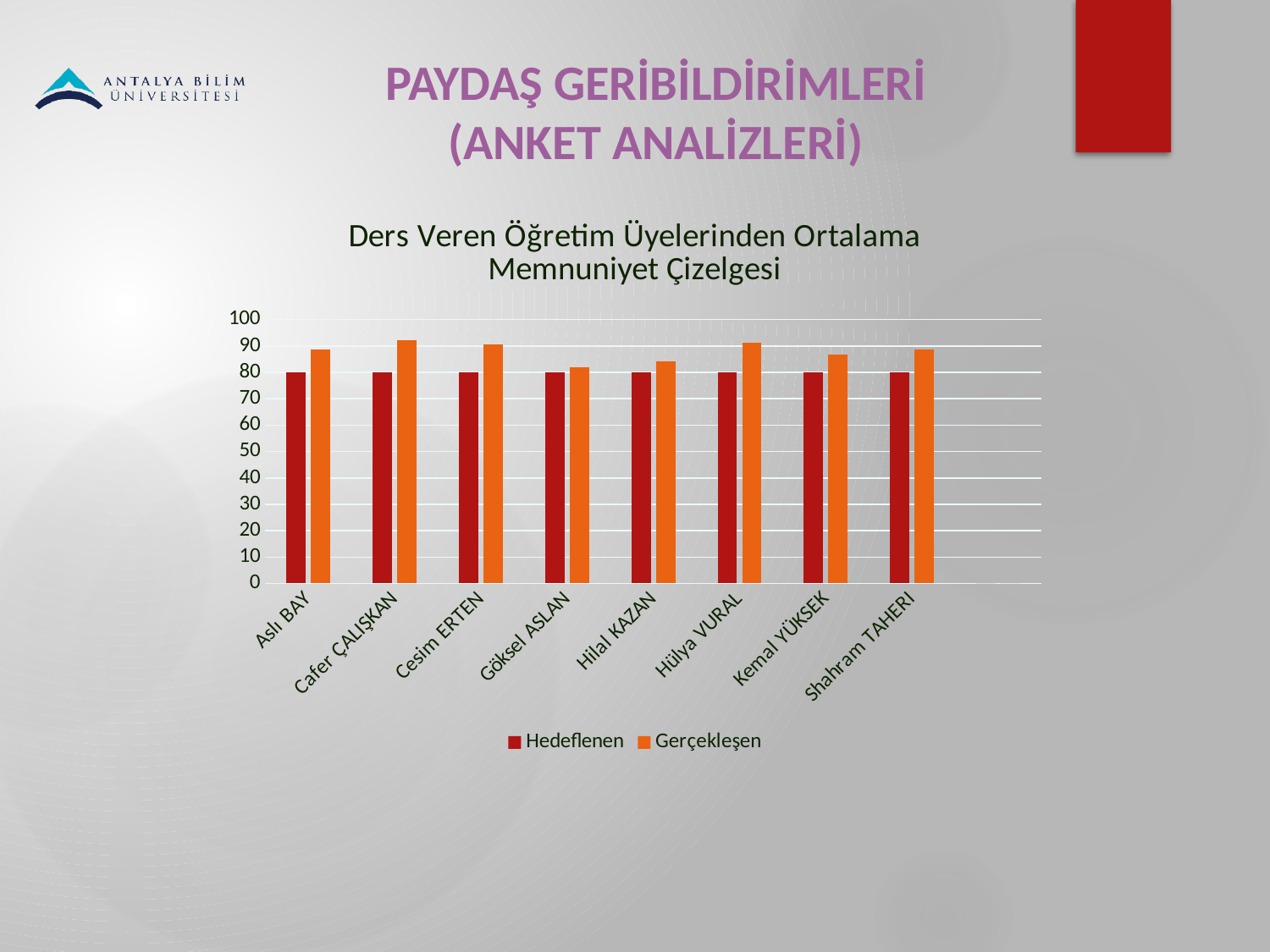
How many instructors (categories) are shown on the x axis? 8 Which series is shown in orange in the legend? Gerçekleşen Which is larger for Aslı BAY, the Hedeflenen value or the Gerçekleşen value? Gerçekleşen What is the Hedeflenen value for Aslı BAY? 80 Is the Gerçekleşen value for Göksel ASLAN greater or less than 90? less How many series does the legend list? 2 What is the Hedeflenen value for Shahram TAHERI? 80 Which instructor has the lowest Gerçekleşen value? Göksel ASLAN What kind of chart is shown on the slide? bar chart Is the Gerçekleşen value for Cafer ÇALIŞKAN greater or less than 90? greater Is the Gerçekleşen value for Kemal YÜKSEK greater or less than 80? greater What is the title of the chart? Ders Veren Öğretim Üyelerinden Ortalama Memnuniyet Çizelgesi